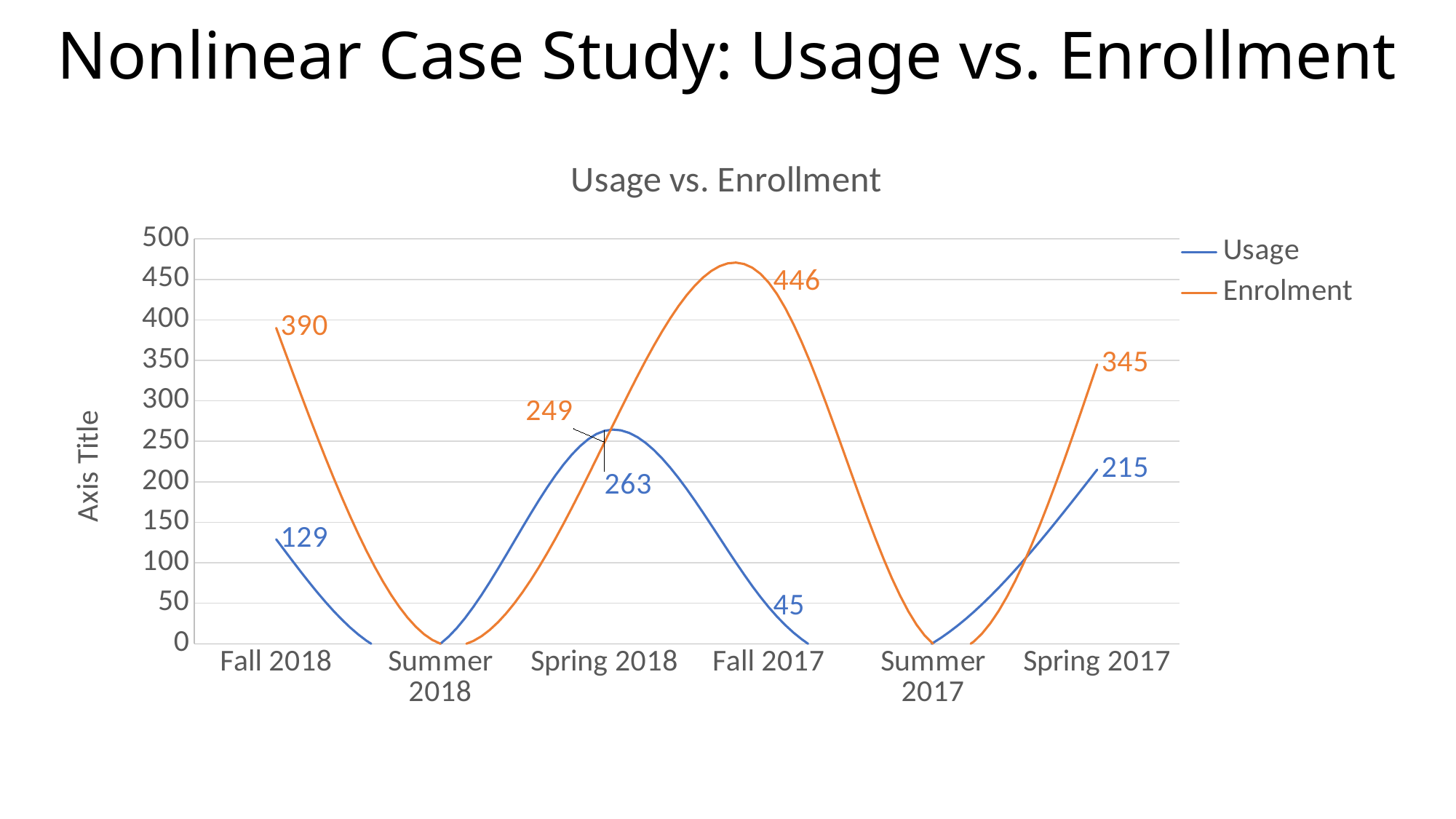
What is the Usage value for Spring 2017? 215 What is the Enrolment value for Fall 2017? 446 What is the Enrolment value for Spring 2018? 249 How many periods are shown on the x axis? 6 What is the Usage value for Fall 2018? 129 In which period does Usage reach its highest value? Spring 2018 What kind of chart is shown on the slide? Line chart What is the difference between Enrolment and Usage in Fall 2018? 261 In which period does Enrolment reach its highest value? Fall 2017 How many series does the legend list? 2 How much higher is Usage in Spring 2018 than in Fall 2017? 218 In Spring 2018, which is larger, Usage or Enrolment? Usage